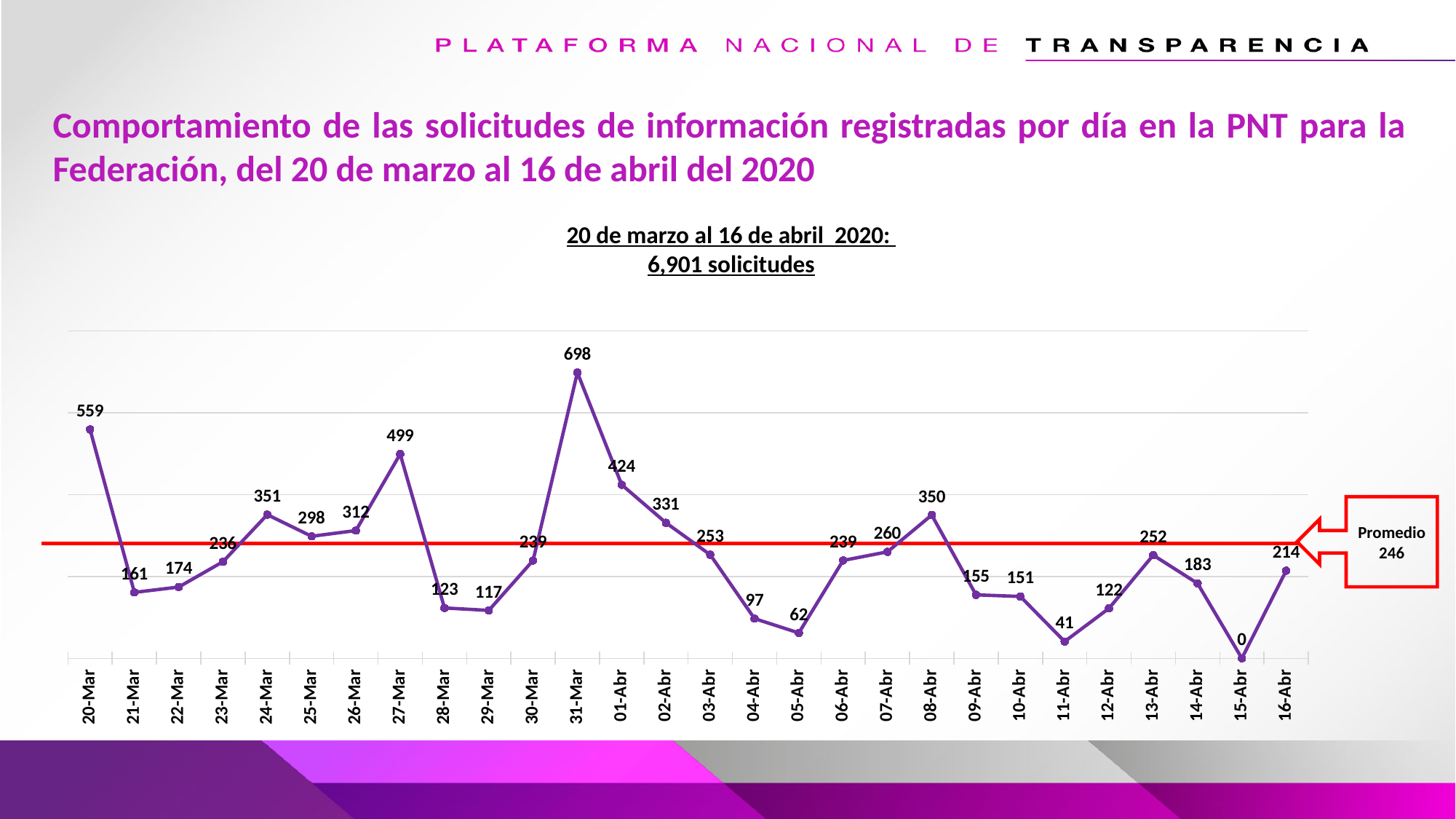
Which day has the lowest number of requests? 15-Abr Do the values rise or fall from 11-Abr to 13-Abr? rise What is the value for 05-Abr? 62 How many requests were registered on 31-Mar? 698 How many requests were registered on 20-Mar? 559 What average (Promedio) value does the red horizontal line represent? 246 How many days (data points) are plotted on the chart? 28 What type of chart is shown on the slide? line chart Which day has the highest number of requests? 31-Mar What is the total number of requests for the period 20 de marzo al 16 de abril 2020, as stated on the slide? 6,901 solicitudes Which is larger, the value for 27-Mar or the value for 08-Abr? 27-Mar What is the difference between the values for 31-Mar and 01-Abr? 274